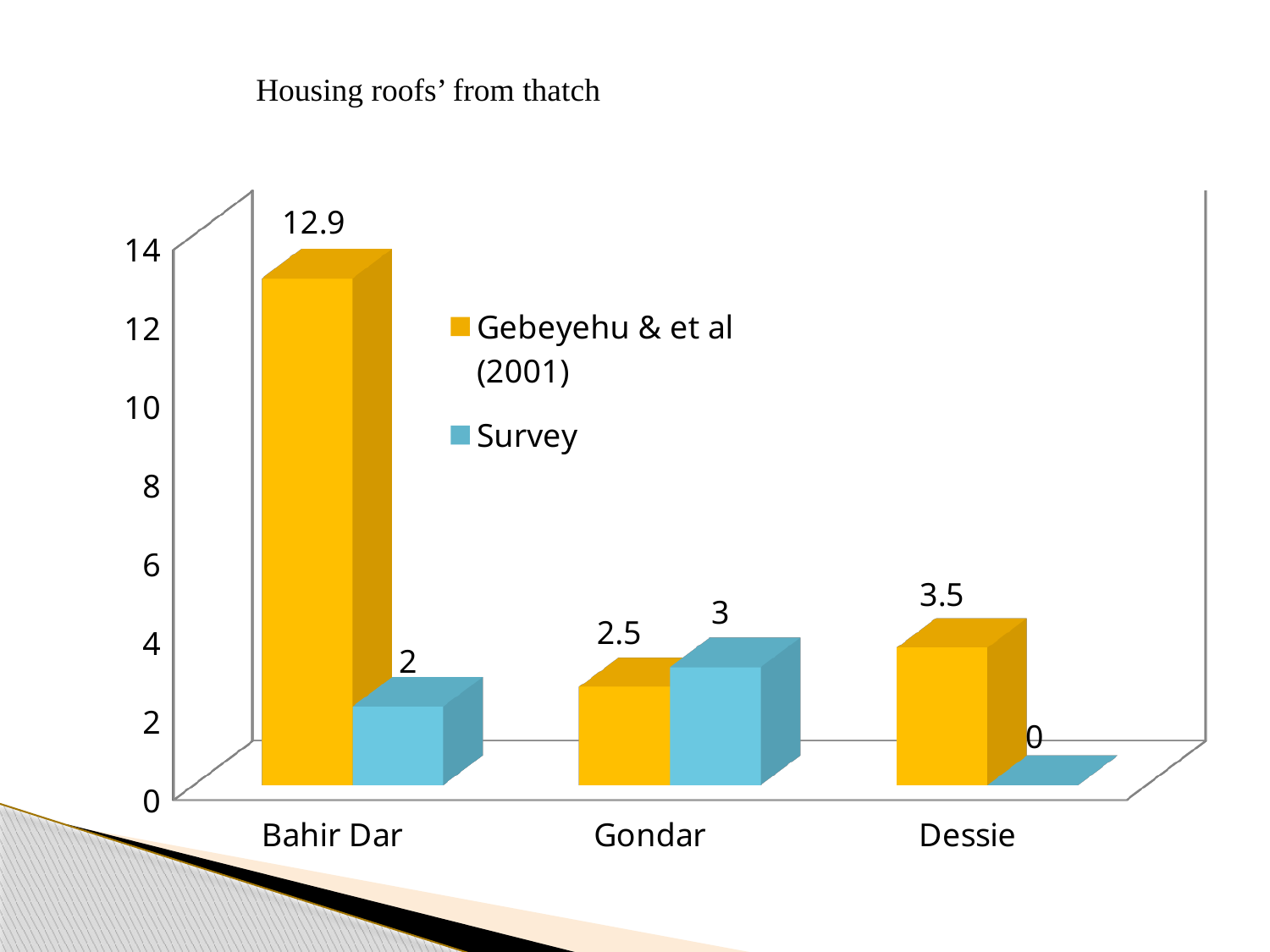
What is the title of the chart? Housing roofs' from thatch How many series does the legend list? 2 For Gondar, which is larger: the Gebeyehu & et al (2001) value or the Survey value? Survey What is the difference between the Gebeyehu & et al (2001) value and the Survey value for Bahir Dar? 10.9 What is the Survey value for Gondar? 3 What is the Gebeyehu & et al (2001) value for Dessie? 3.5 Which city has the highest Gebeyehu & et al (2001) value? Bahir Dar What is the Survey value for Dessie? 0 What kind of chart is shown on the slide? Bar chart What is the Gebeyehu & et al (2001) value for Bahir Dar? 12.9 Which city has the lowest Survey value? Dessie How many cities are shown on the x axis? 3